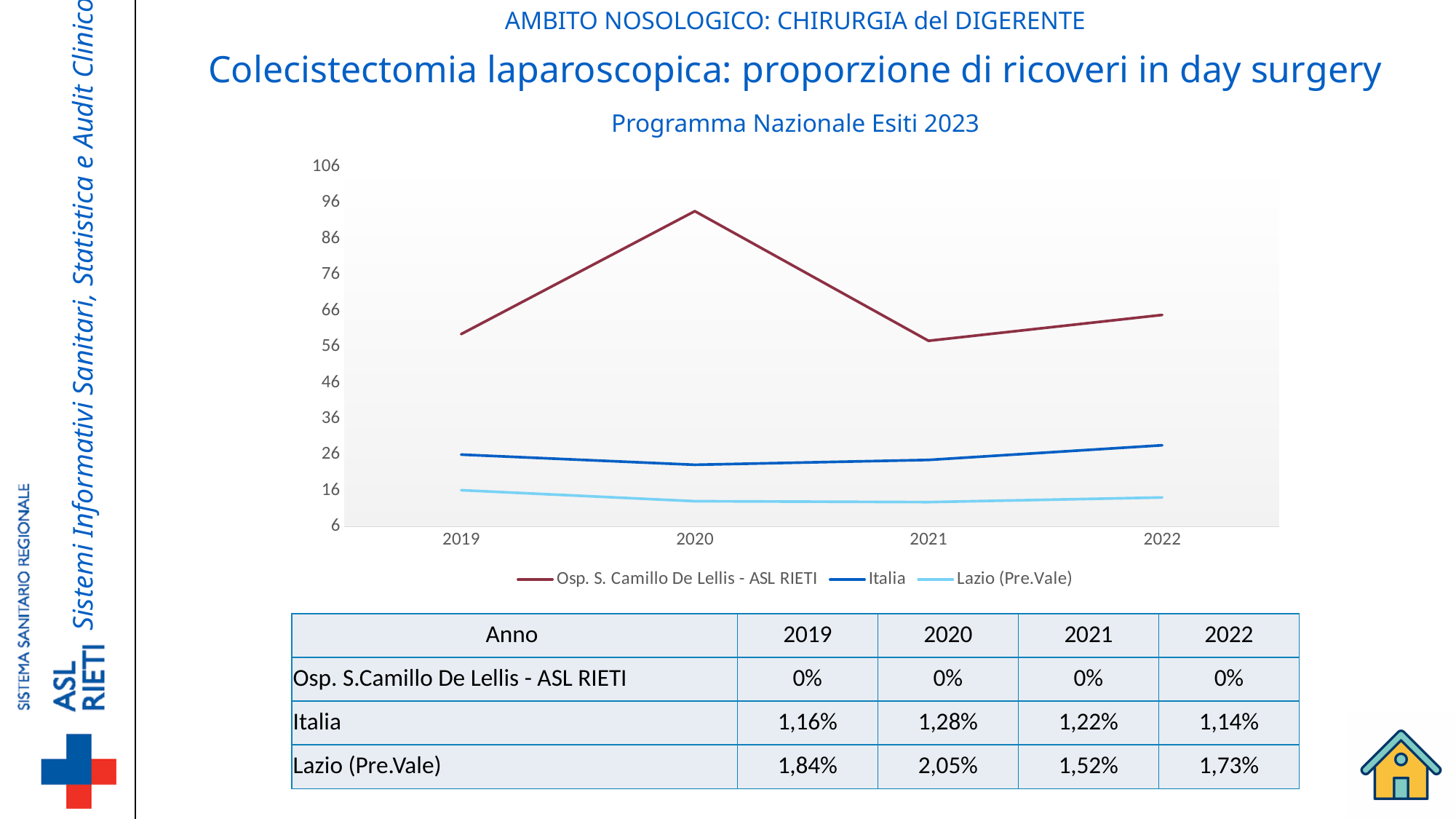
How many series does the chart legend list? 3 In which year does the Italia line reach its highest value? 2022 Is the value for Lazio (Pre.Vale) in 2020 greater or less than 16? less In 2019, which series has the larger value: Osp. S. Camillo De Lellis - ASL RIETI or Italia? Osp. S. Camillo De Lellis - ASL RIETI In which year does the Lazio (Pre.Vale) line reach its highest value? 2019 How many years are plotted along the x axis of the chart? 4 Is the value for Osp. S. Camillo De Lellis - ASL RIETI in 2021 greater or less than 66? less Does the Osp. S. Camillo De Lellis - ASL RIETI line rise or fall from 2020 to 2021? fall Is the value for Osp. S. Camillo De Lellis - ASL RIETI in 2020 greater or less than 86? greater What is the subtitle shown directly above the chart? Programma Nazionale Esiti 2023 What kind of chart is shown on the slide? line chart In which year does the Osp. S. Camillo De Lellis - ASL RIETI line reach its highest value? 2020